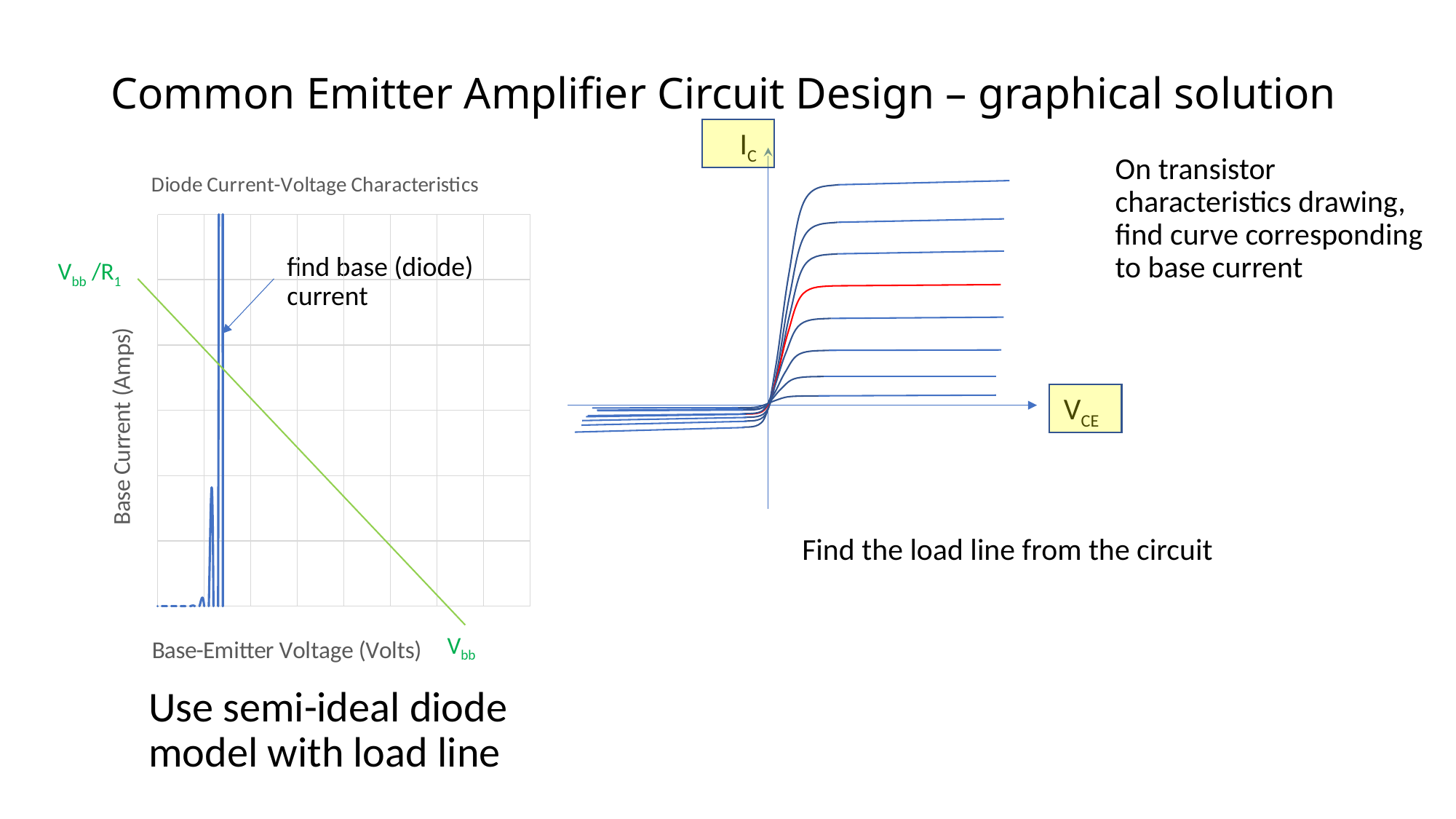
In the transistor characteristics drawing on the right, how many curves are plotted in the first quadrant? 8 What kind of chart is the Diode Current-Voltage Characteristics chart? line chart What is the title of the chart on the left of the slide? Diode Current-Voltage Characteristics In the Diode Current-Voltage Characteristics chart, does the green load line rise or fall as Base-Emitter Voltage increases? fall What is the y-axis label of the Diode Current-Voltage Characteristics chart? Base Current (Amps)